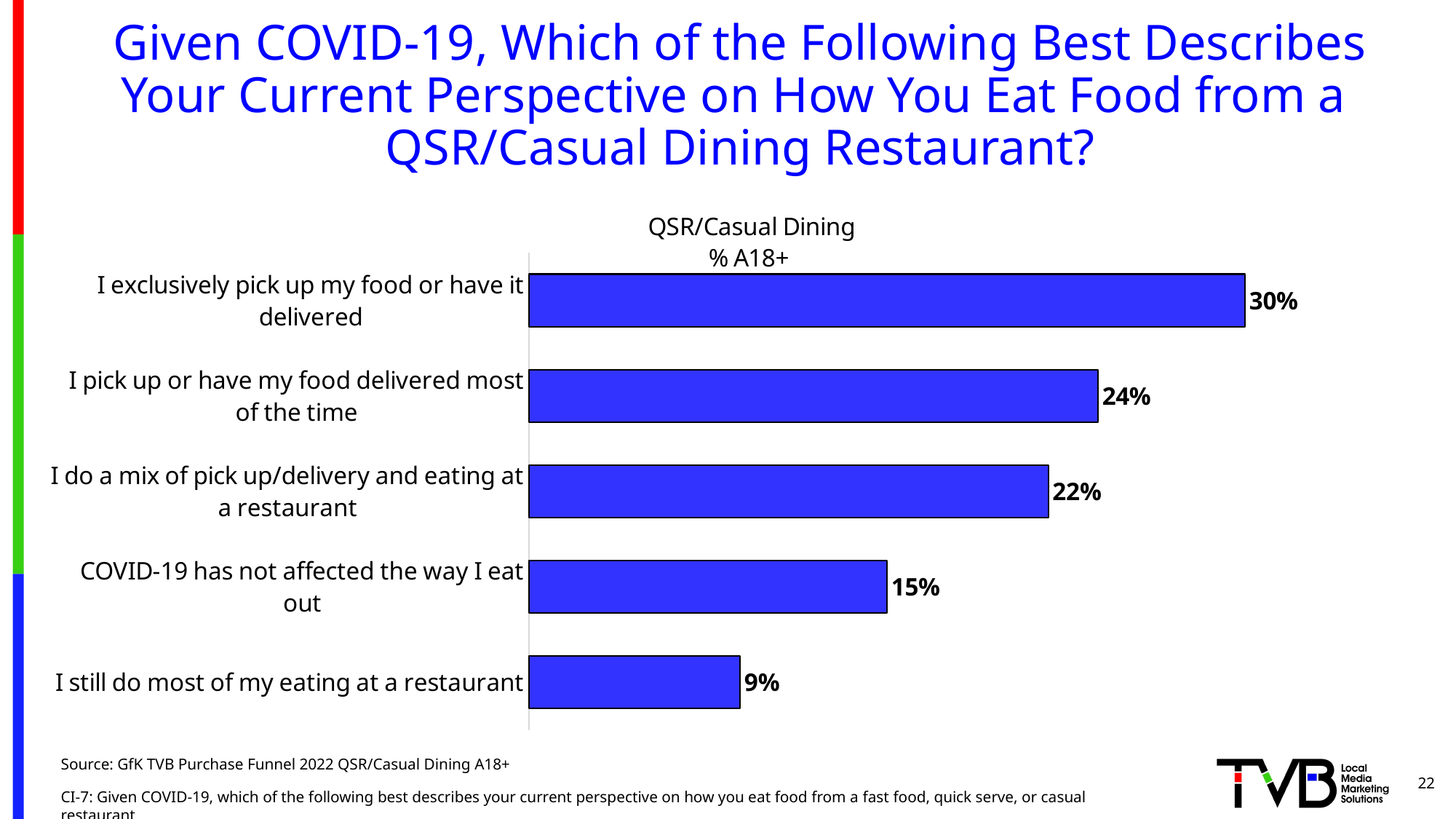
What percentage say they do a mix of pick up/delivery and eating at a restaurant? 22% How many response categories are shown in the chart? 5 What is the difference in percentage points between "I exclusively pick up my food or have it delivered" and "I still do most of my eating at a restaurant"? 21 Which response has the lowest percentage? I still do most of my eating at a restaurant What is the value for "COVID-19 has not affected the way I eat out"? 15% What type of chart is shown on the slide? Bar chart Which is larger: the value for "I pick up or have my food delivered most of the time" or the value for "COVID-19 has not affected the way I eat out"? I pick up or have my food delivered most of the time What is the value for "I pick up or have my food delivered most of the time"? 24% What percentage say they still do most of their eating at a restaurant? 9% Which response has the highest percentage? I exclusively pick up my food or have it delivered What is the title shown above the chart? QSR/Casual Dining % A18+ What percentage of respondents say they exclusively pick up their food or have it delivered? 30%